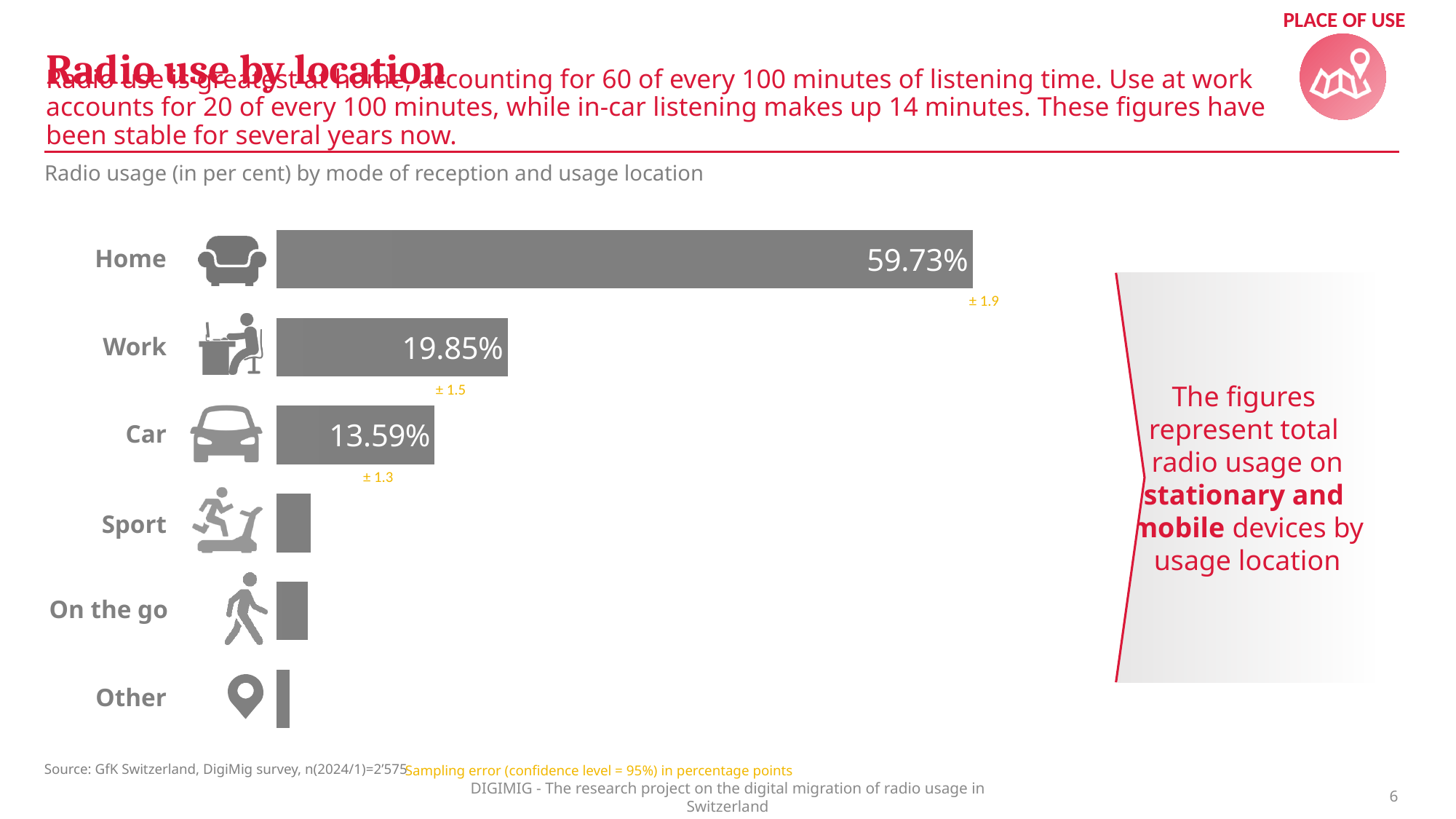
What is the value for Car? 13.59% Which location has the highest radio usage? Home What is the sampling error shown for the Home bar? ± 1.9 Which is larger, the value for Work or the value for Car? Work How many usage locations are shown in the chart? 6 What is the difference between the values for Work and Car? 6.26 percentage points What is the value for Work? 19.85% Which is larger, the value for Car or the value for Sport? Car What is the value for Home? 59.73% What is the difference between the values for Home and Work? 39.88 percentage points Which location has the lowest radio usage? Other What kind of chart is shown on the slide? Bar chart